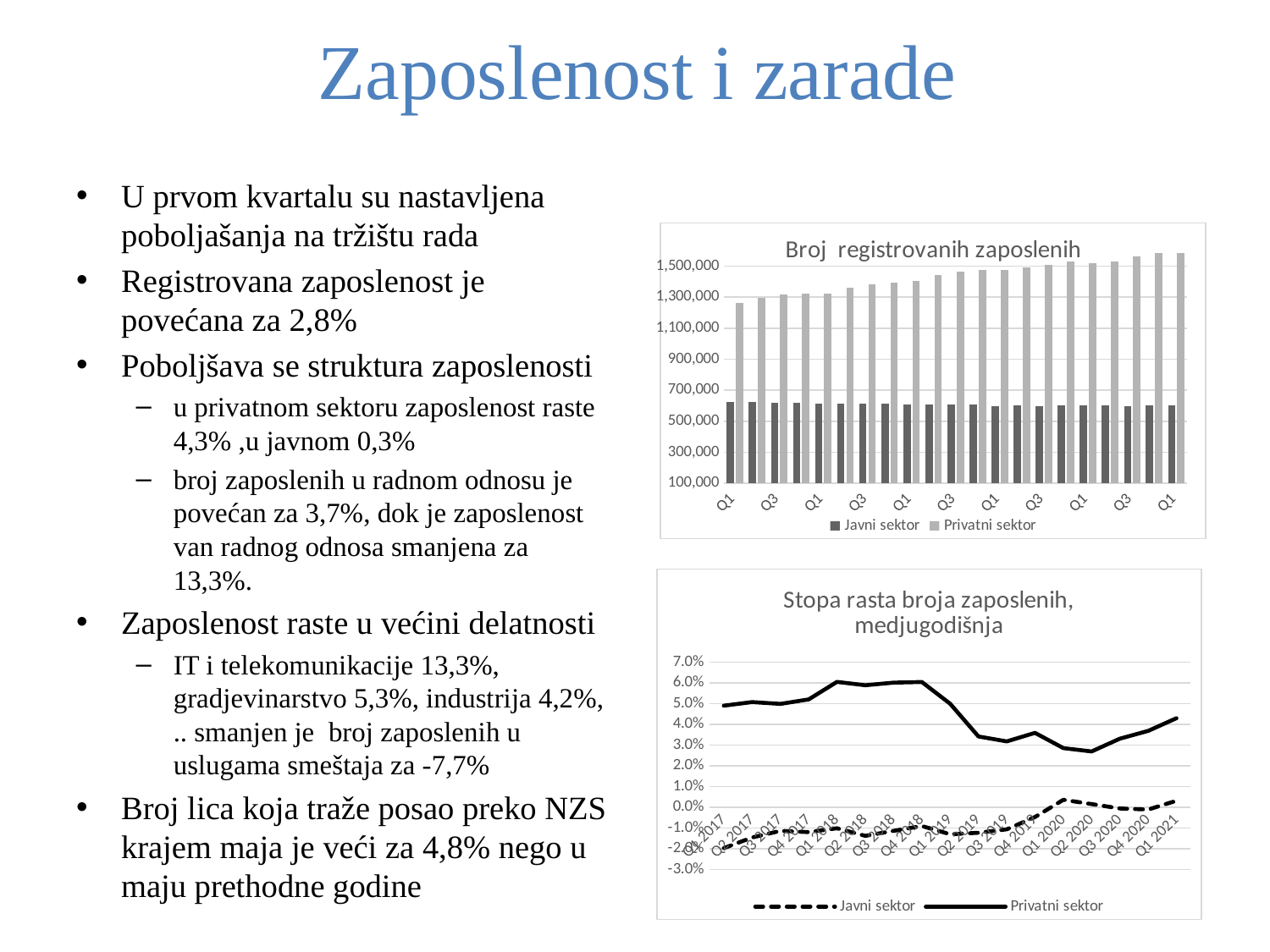
In the 'Stopa rasta broja zaposlenih, medjugodišnja' chart, is the value for Privatni sektor in Q2 2018 greater or less than 5.0%? greater In the 'Broj registrovanih zaposlenih' chart, which series has the taller bars in every quarter, Javni sektor or Privatni sektor? Privatni sektor What kind of chart is the 'Broj registrovanih zaposlenih' chart? bar chart In the 'Stopa rasta broja zaposlenih, medjugodišnja' chart, which series is higher in Q1 2021, Javni sektor or Privatni sektor? Privatni sektor In the 'Broj registrovanih zaposlenih' chart, do the Privatni sektor bars generally rise or fall from left to right? rise In the 'Stopa rasta broja zaposlenih, medjugodišnja' chart, is the value for Javni sektor in Q1 2017 greater or less than 0.0%? less How many series does the legend of the 'Broj registrovanih zaposlenih' chart list? 2 How many quarters are plotted on the x axis of the 'Stopa rasta broja zaposlenih, medjugodišnja' chart? 17 In the 'Broj registrovanih zaposlenih' chart, is the value for Privatni sektor in the first Q1 shown greater or less than 1,100,000? greater What kind of chart is the 'Stopa rasta broja zaposlenih, medjugodišnja' chart? line chart In the 'Stopa rasta broja zaposlenih, medjugodišnja' chart, which series is drawn with a dashed line? Javni sektor